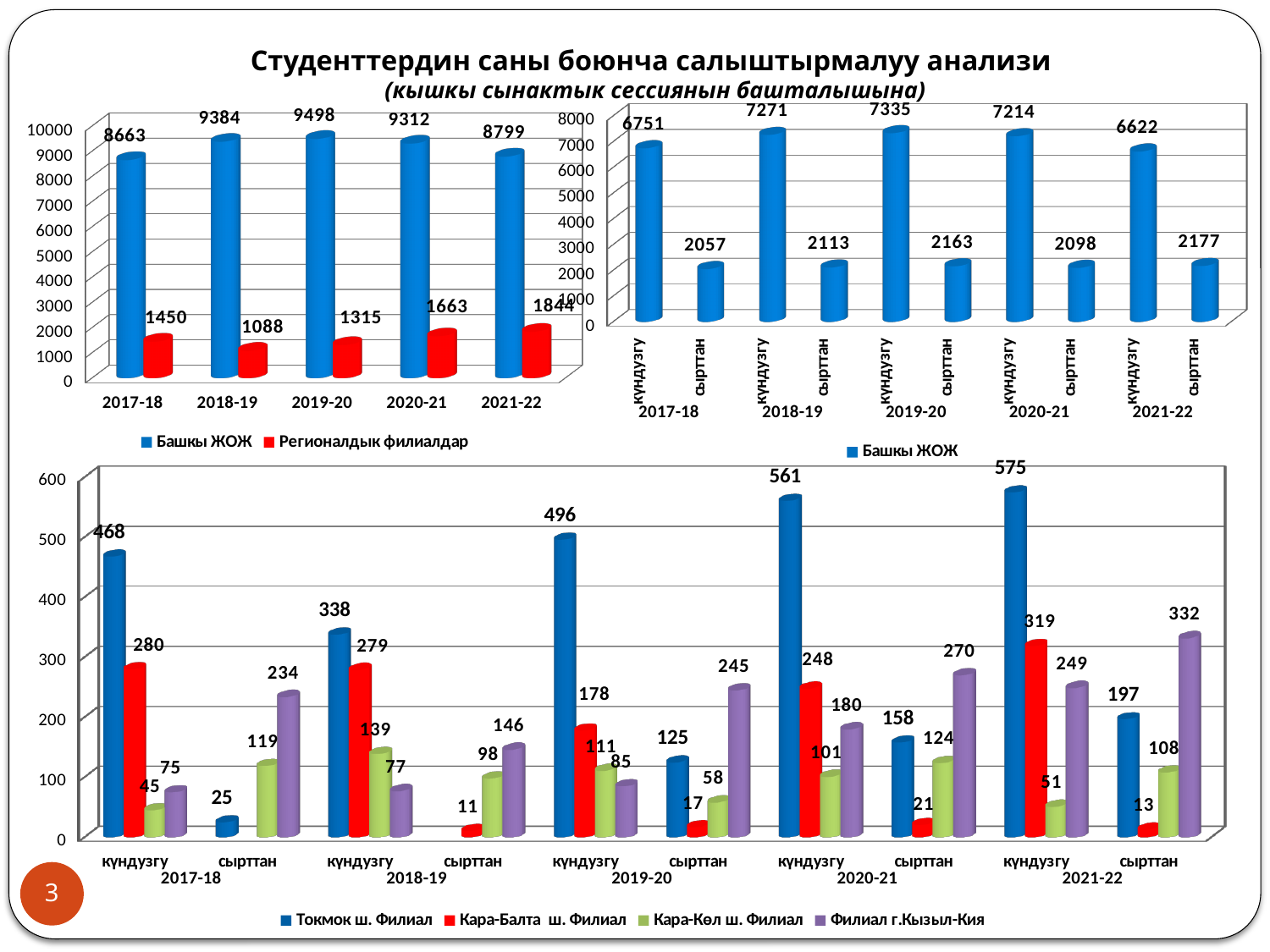
In the top-left chart, which year has the highest value for Регионалдык филиалдар? 2021-22 In the top-right chart, which year has the lowest күндүзгү value? 2021-22 What kind of chart is the bottom chart? Bar chart In the top-left chart, what is the value for Башкы ЖОЖ in 2019-20? 9498 In the top-right chart, is the күндүзгү value for 2018-19 greater or less than 7000? greater In the bottom chart, what is the value for Токмок ш. Филиал for күндүзгү in 2020-21? 561 In the top-left chart, what is the difference between Башкы ЖОЖ and Регионалдык филиалдар in 2017-18? 7213 In the top-right chart, what is the value for сырттан in 2020-21? 2098 In the bottom chart, what is the difference between Токмок ш. Филиал and Кара-Балта ш. Филиал for күндүзгү in 2019-20? 318 In the top-left chart, how many series does the legend list? 2 In the bottom chart, which series has the highest value for сырттан in 2021-22? Филиал г.Кызыл-Кия In the bottom chart, which is larger: Кара-Балта ш. Филиал for күндүзгү in 2017-18 or in 2021-22? 2021-22